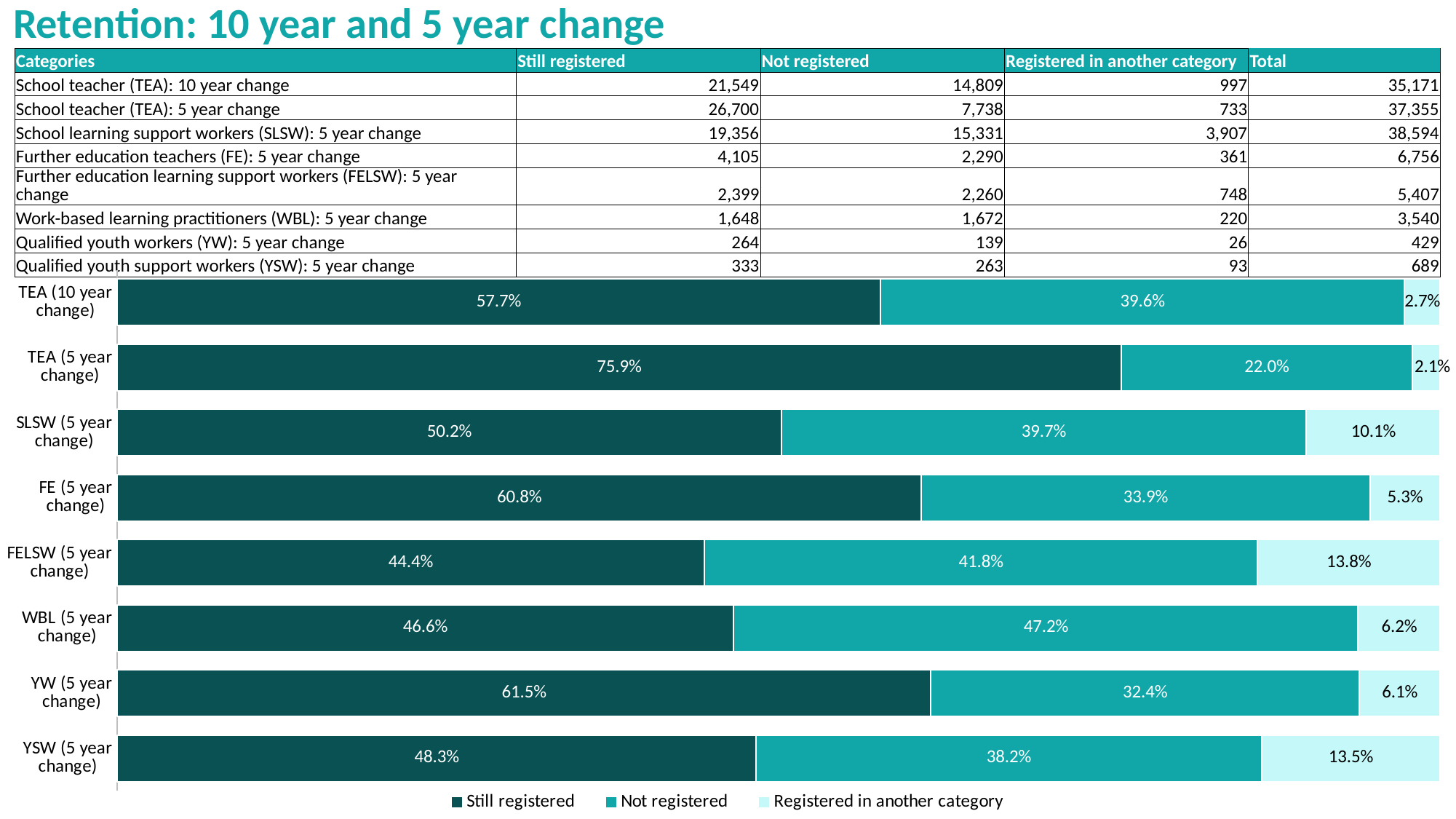
How many categories are shown in the bar chart? 8 In the bar chart, which category has the lowest 'Still registered' percentage? FELSW (5 year change) In the bar chart, what is the difference in 'Still registered' percentage between TEA (5 year change) and TEA (10 year change)? 18.2 percentage points What are the three legend entries of the bar chart? Still registered, Not registered, Registered in another category How many series does the bar chart's legend list? 3 In the bar chart, what is the 'Registered in another category' percentage for FELSW (5 year change)? 13.8% In the bar chart, which has a larger 'Not registered' percentage: FELSW (5 year change) or YSW (5 year change)? FELSW (5 year change) In the bar chart, which category has the lowest 'Not registered' percentage? TEA (5 year change) In the bar chart, which category has the highest 'Still registered' percentage? TEA (5 year change) What type of chart is shown below the table? Stacked bar chart In the bar chart, what is the 'Not registered' percentage for WBL (5 year change)? 47.2% In the bar chart, what is the 'Still registered' percentage for TEA (5 year change)? 75.9%